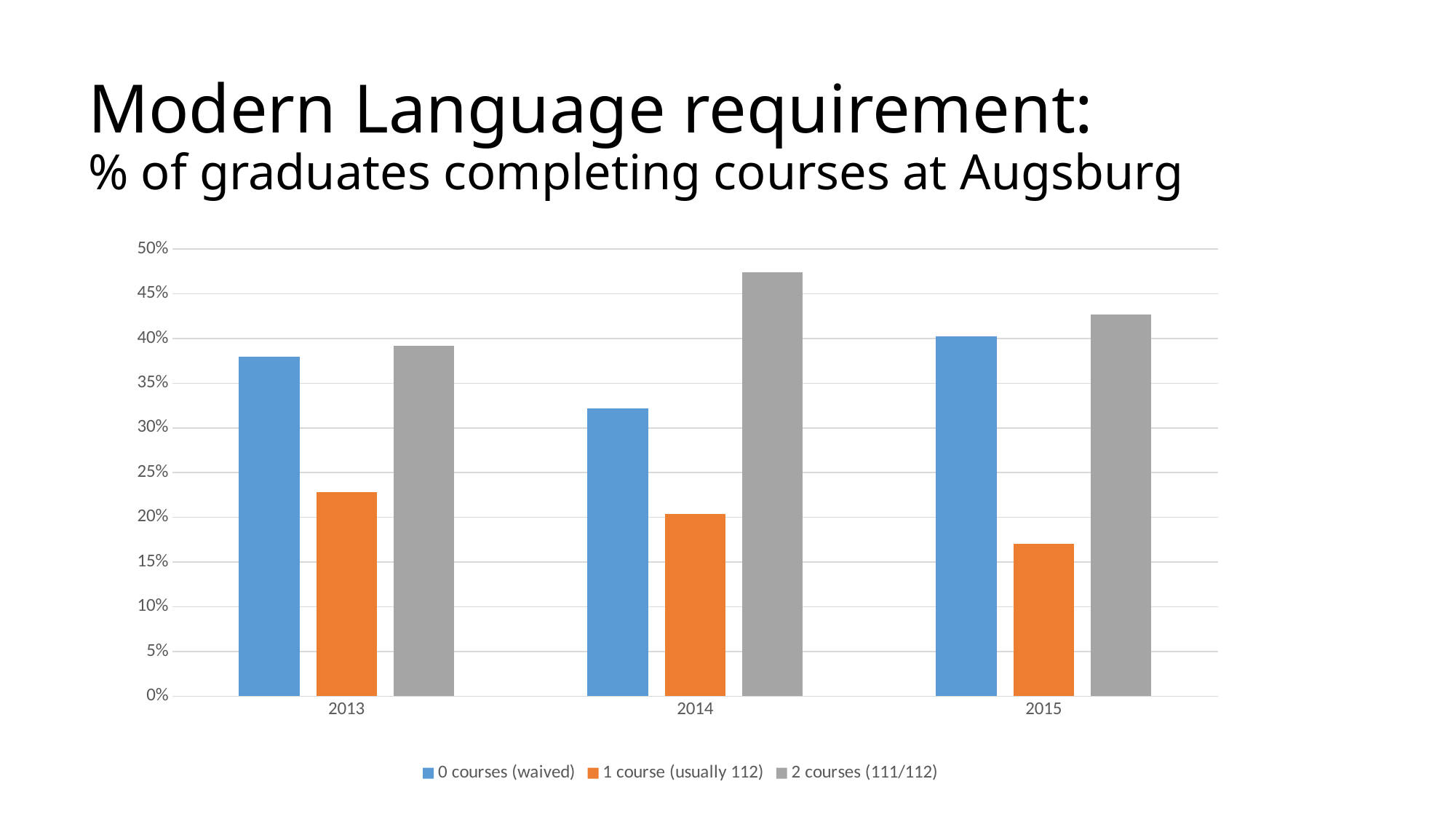
Is the value for 1 course (usually 112) in 2013 greater or less than 20%? greater Is the value for 2 courses (111/112) in 2014 greater or less than 45%? greater Which series and year has the highest bar in the chart? 2 courses (111/112) in 2014 In 2014, which is larger: 0 courses (waived) or 2 courses (111/112)? 2 courses (111/112) What kind of chart is shown on the slide? bar chart What colour are the bars for the 1 course (usually 112) series? orange Which series and year has the lowest bar in the chart? 1 course (usually 112) in 2015 How many series does the legend list? 3 Is the value for 1 course (usually 112) in 2015 greater or less than 20%? less Does the 1 course (usually 112) series rise or fall from 2013 to 2015? fall How many years are shown on the x axis? 3